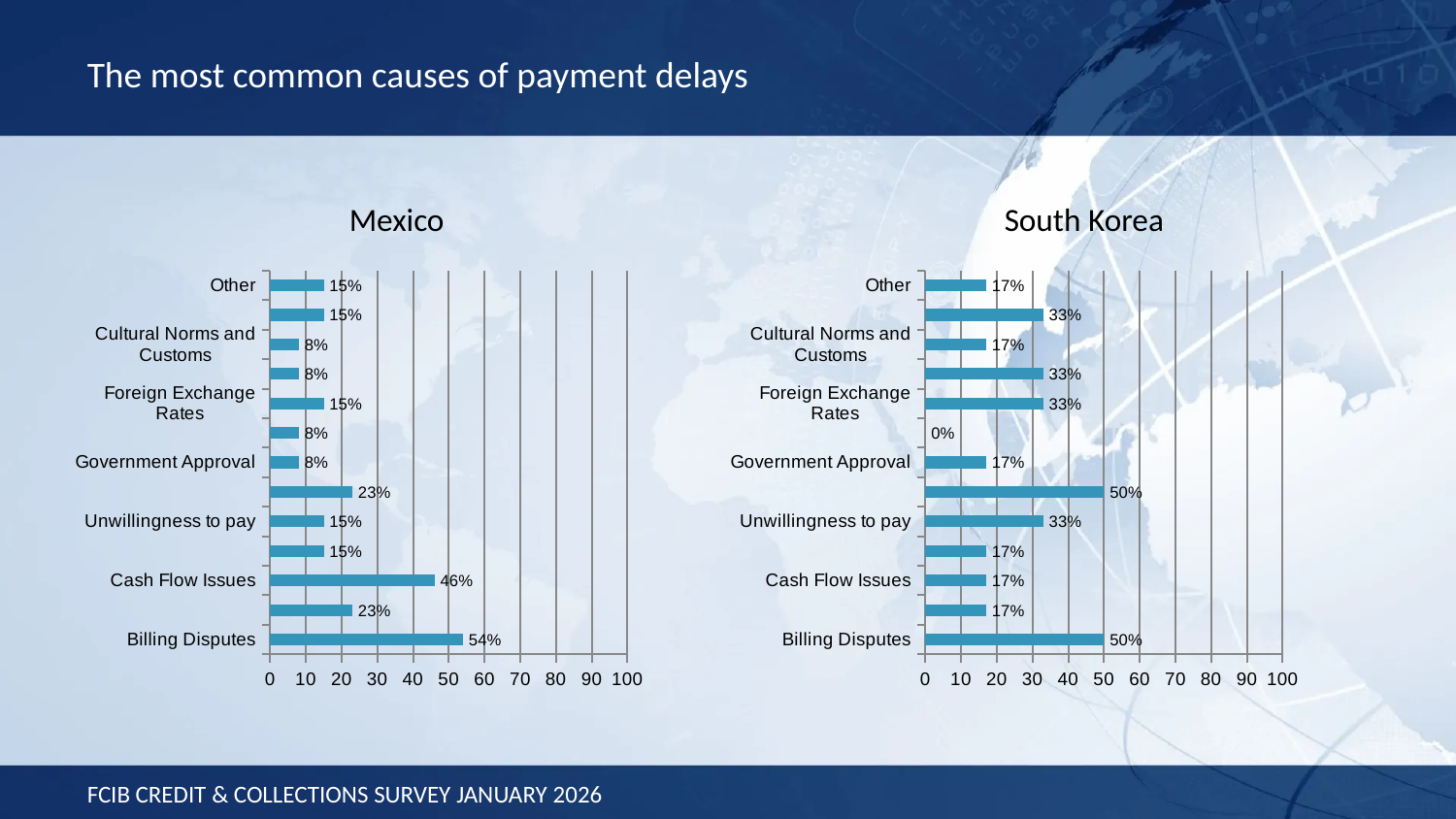
What is the title of the slide containing the two charts? The most common causes of payment delays In the Mexico chart, is the value for Billing Disputes greater or less than 50? greater In the South Korea chart, what is the value for Foreign Exchange Rates? 33% In the Mexico chart, what is the value for Government Approval? 8% In the Mexico chart, what is the value for Billing Disputes? 54% In the Mexico chart, what is the difference between Billing Disputes and Cash Flow Issues? 8 percentage points In the Mexico chart, what is the value for Cash Flow Issues? 46% In the South Korea chart, what is the value for Other? 17% Which chart shows a larger value for Cash Flow Issues, Mexico or South Korea? Mexico What kind of chart is the South Korea chart? Bar chart In the Mexico chart, which category has the highest value? Billing Disputes In the South Korea chart, what is the value for Billing Disputes? 50%